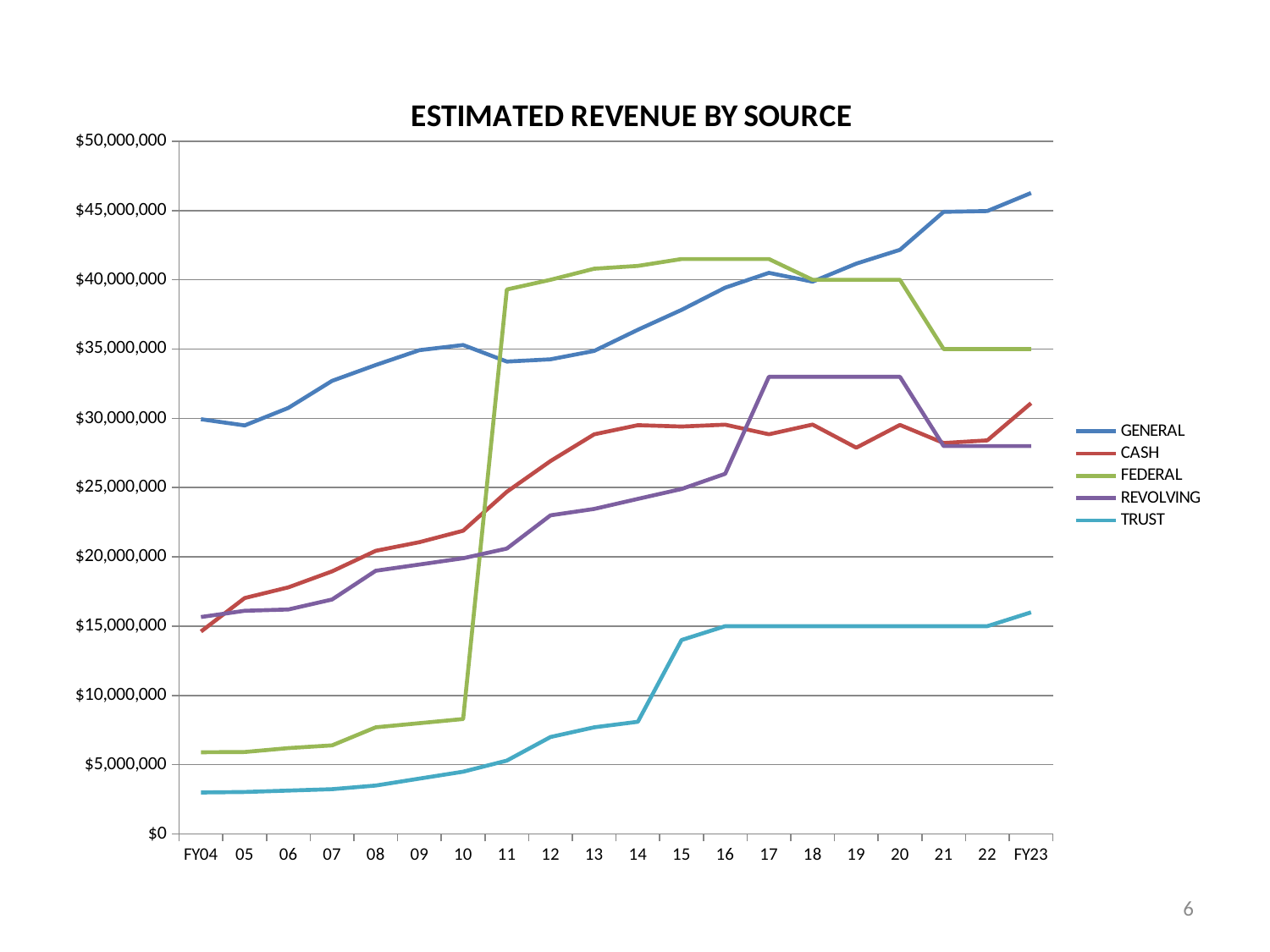
How many fiscal years are plotted along the x axis? 20 How many series does the legend list? 5 Is the value for FEDERAL at FY10 greater or less than $10,000,000? less Which series is lowest at FY23? TRUST Does the GENERAL series generally rise or fall from FY04 to FY23? rise At FY12, which is larger, FEDERAL or GENERAL? FEDERAL Which series is highest at FY15? FEDERAL Is the value for TRUST at FY04 greater or less than $5,000,000? less What kind of chart is shown on the slide? line chart Is the value for GENERAL at FY23 greater or less than $45,000,000? greater What is the title of the chart? ESTIMATED REVENUE BY SOURCE Which series is highest at FY23? GENERAL